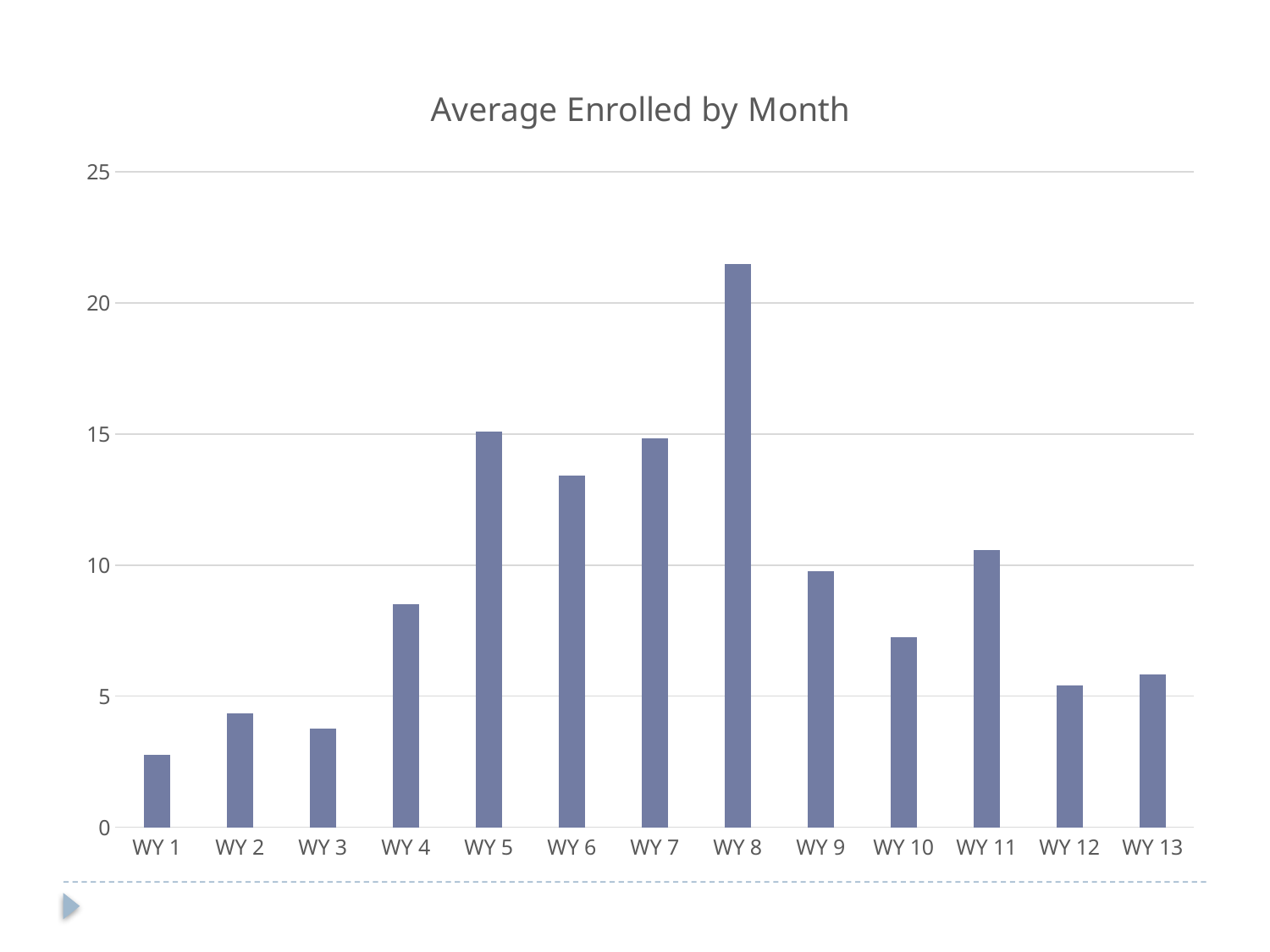
Which is larger, the value for WY 4 or the value for WY 10? WY 4 Is the value for WY 8 greater or less than 20? greater What type of chart is shown on the slide? bar chart Is the value for WY 4 greater or less than 10? less Which is larger, the value for WY 5 or the value for WY 8? WY 8 Do the values rise or fall from WY 8 to WY 10? fall Which category has the highest value in the chart? WY 8 Which category has the lowest value in the chart? WY 1 Is the value for WY 1 greater or less than 5? less What is the title of the chart? Average Enrolled by Month How many categories are shown on the x axis of the chart? 13